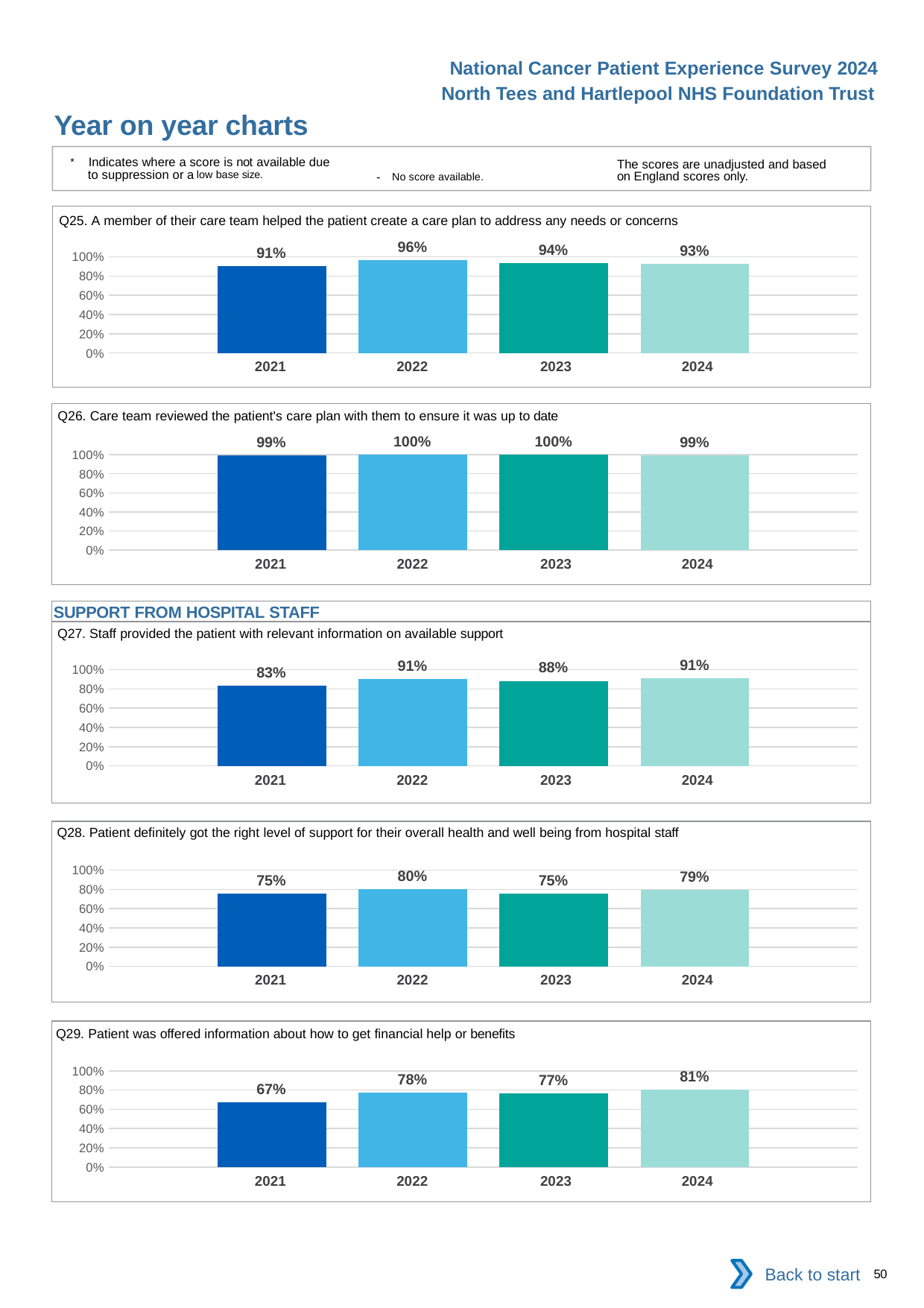
In the Q29 chart, what is the value for 2021? 67% In the Q27 chart, what is the difference between the 2022 and 2021 values? 8% In the Q25 chart, what is the value for 2022? 96% In the Q28 chart, which year has the highest value? 2022 In the Q25 chart, which year has the lowest value? 2021 In the Q27 chart, which is larger, the value for 2023 or the value for 2024? 2024 In the Q29 chart, what is the difference between the 2024 and 2021 values? 14% How many years are shown in the Q26 chart? 4 What kind of chart is the Q25 chart? bar chart In the Q28 chart, what is the value for 2024? 79% In the Q29 chart, is the value for 2021 greater or less than 80%? less In the Q26 chart, what is the value for 2024? 99%